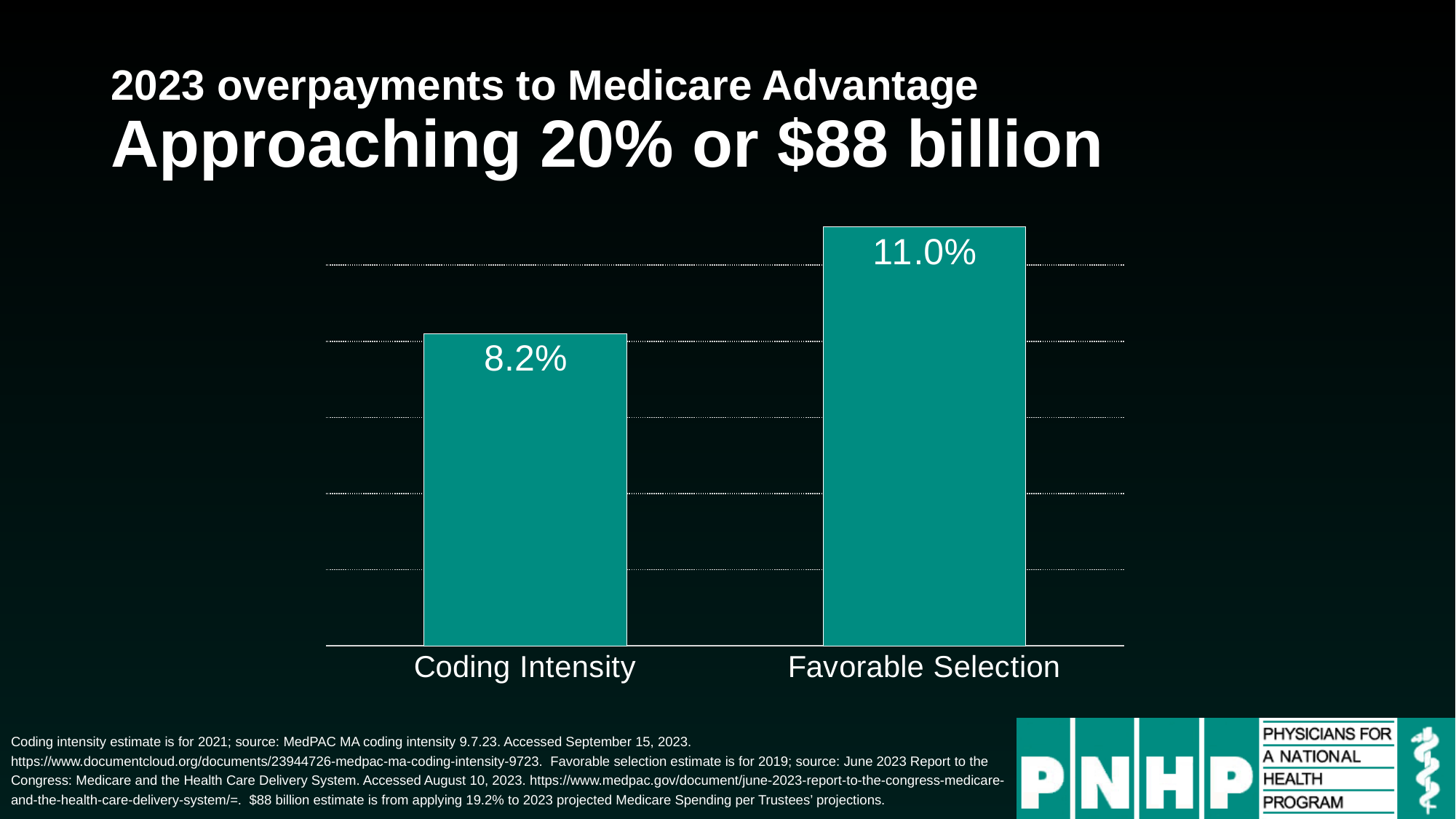
What is the main title text on the slide above the chart? Approaching 20% or $88 billion Which category has the highest value? Favorable Selection What is the difference between the Favorable Selection and Coding Intensity values? 2.8% What kind of chart is shown on the slide? Bar chart What is the value for Favorable Selection? 11.0% What colour are the bars in the chart? Teal What is the total of the two bar values shown on the chart? 19.2% Which is larger, the value for Coding Intensity or the value for Favorable Selection? Favorable Selection Which category has the lowest value? Coding Intensity What is the value for Coding Intensity? 8.2% How many categories are shown on the chart? 2